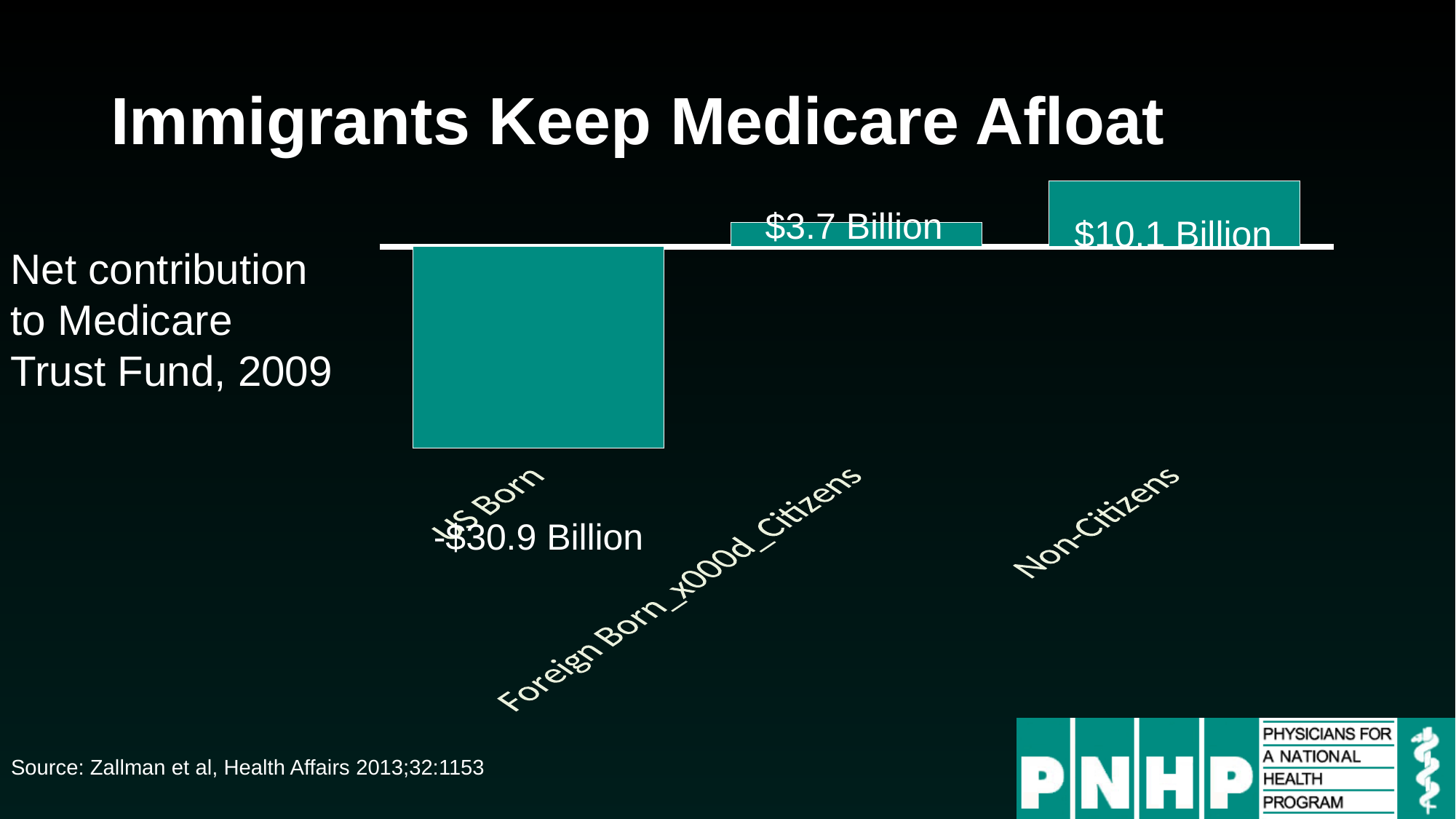
What year does the chart's net contribution data refer to? 2009 How many categories have a negative net contribution? 1 What is the net contribution to the Medicare Trust Fund for US Born? -$30.9 Billion Which has a larger net contribution, Non-Citizens or Foreign Born Citizens? Non-Citizens What is the net contribution to the Medicare Trust Fund for Foreign Born Citizens (the middle bar)? $3.7 Billion What is the title of the slide? Immigrants Keep Medicare Afloat What is the difference between the net contributions of Non-Citizens and Foreign Born Citizens? $6.4 Billion What kind of chart is shown on the slide? Bar chart What is the net contribution to the Medicare Trust Fund for Non-Citizens? $10.1 Billion Which category has the highest net contribution to the Medicare Trust Fund? Non-Citizens How many categories are shown in the chart? 3 Which category has the lowest net contribution to the Medicare Trust Fund? US Born